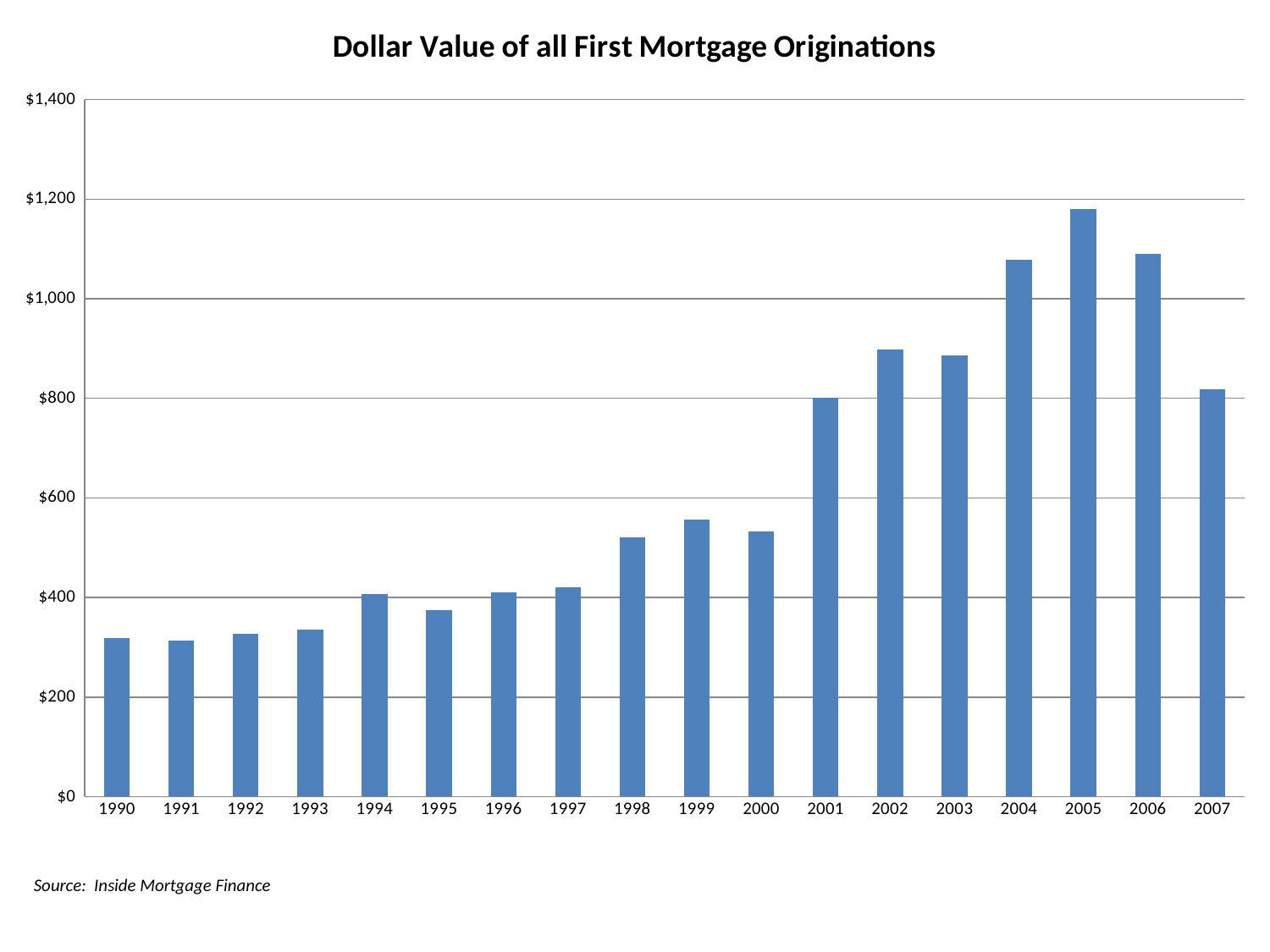
How many years are plotted on the x axis? 18 What kind of chart is shown on the slide? bar chart Is the value for 1995 greater or less than $400? less Is the value for 1990 greater or less than $200? greater Which is larger, the value for 1994 or the value for 1995? 1994 What is the title of the chart? Dollar Value of all First Mortgage Originations Is the value for 2002 greater or less than $1,000? less Which is larger, the value for 2005 or the value for 2007? 2005 Which year has the highest bar? 2005 Do the values generally rise or fall from 1990 to 2005? rise